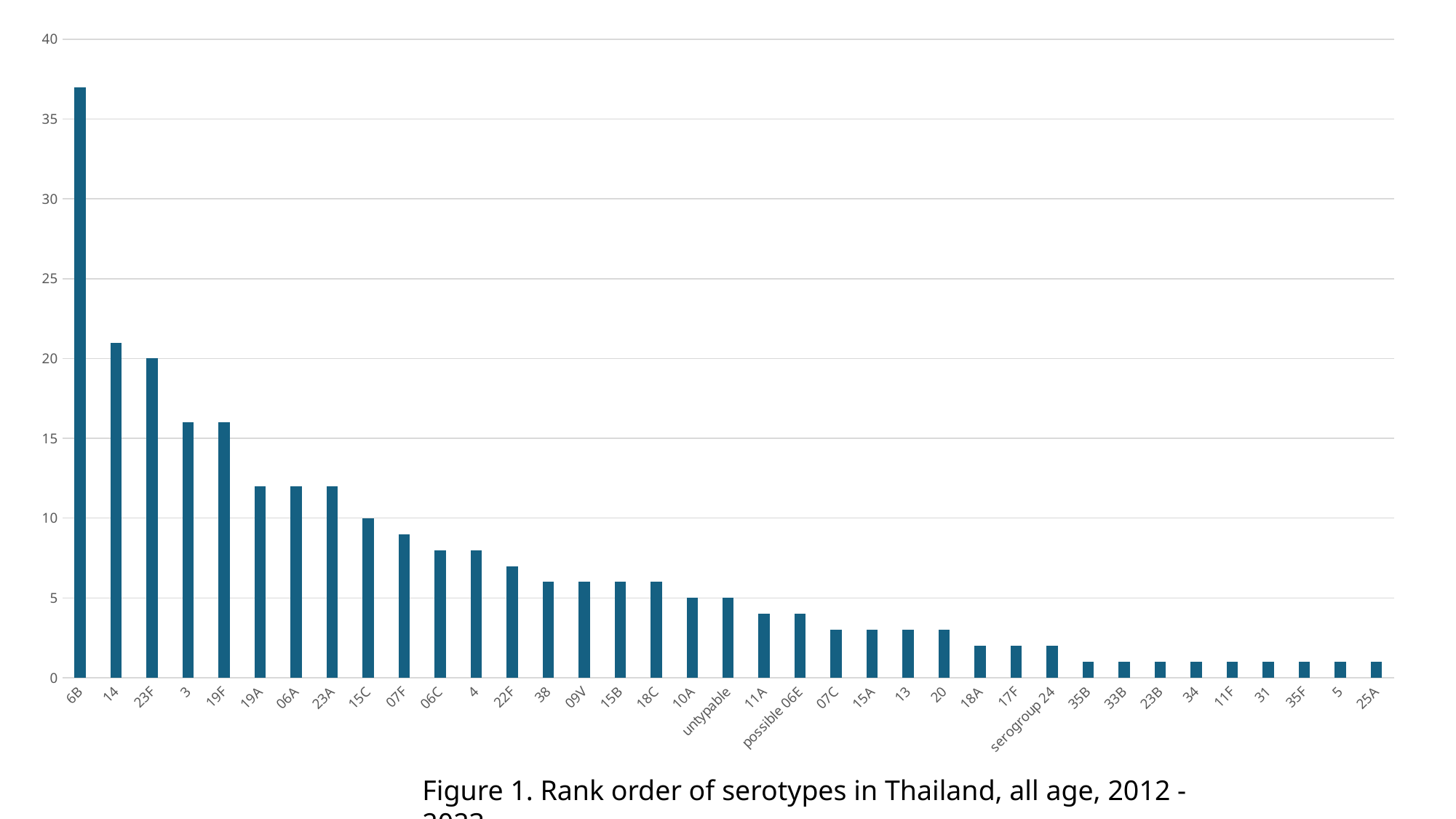
Do the values rise or fall from left to right along the x axis? fall What is the title of the figure? Figure 1. Rank order of serotypes in Thailand, all age, 2012 - 2022 What kind of chart is shown on the slide? bar chart What is the value for serotype 15C? 10 What is the value for serotype 23F? 20 Which has a larger value, 6B or 14? 6B Which serotype has the highest value? 6B What is the value for serotype 10A? 5 Is the value for 07F greater or less than 10? less Is the value for 6B greater or less than 35? greater Is the value for 3 greater or less than 15? greater